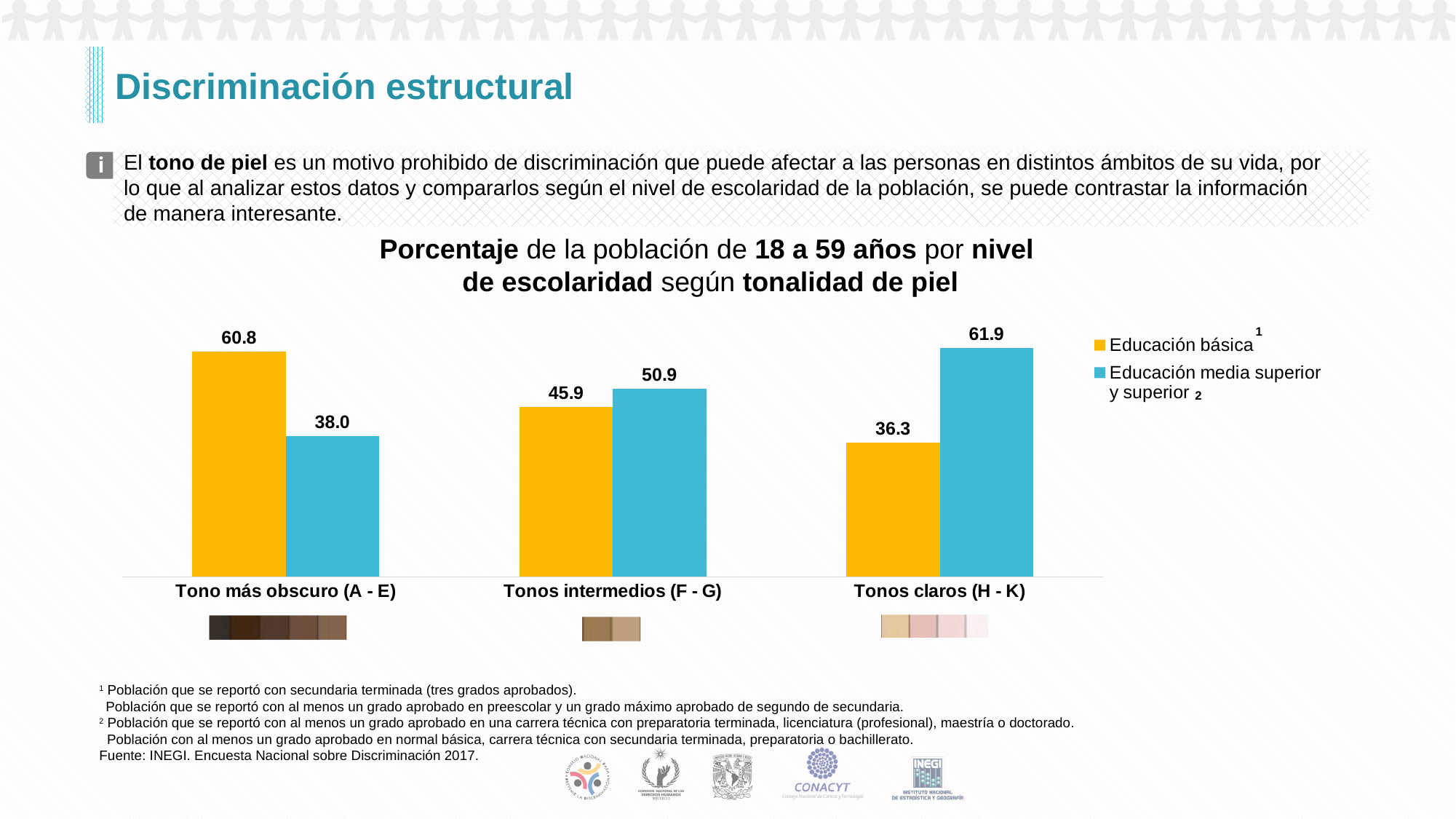
What is the value for Educación básica in the Tonos intermedios (F - G) category? 45.9 How many series does the legend list? 2 What kind of chart is shown on the slide? Bar chart Which category has the highest value for Educación básica? Tono más obscuro (A - E) What is the value for Educación media superior y superior in the Tonos claros (H - K) category? 61.9 In the Tonos intermedios (F - G) category, which series has the larger value? Educación media superior y superior What is the value for Educación media superior y superior in the Tono más obscuro (A - E) category? 38.0 How many skin tone categories are shown on the x axis? 3 What is the difference between Educación básica and Educación media superior y superior in the Tonos claros (H - K) category? 25.6 What is the value for Educación básica in the Tono más obscuro (A - E) category? 60.8 Which category has the lowest value for Educación media superior y superior? Tono más obscuro (A - E) Does the value for Educación básica rise or fall from Tono más obscuro (A - E) to Tonos claros (H - K)? Fall